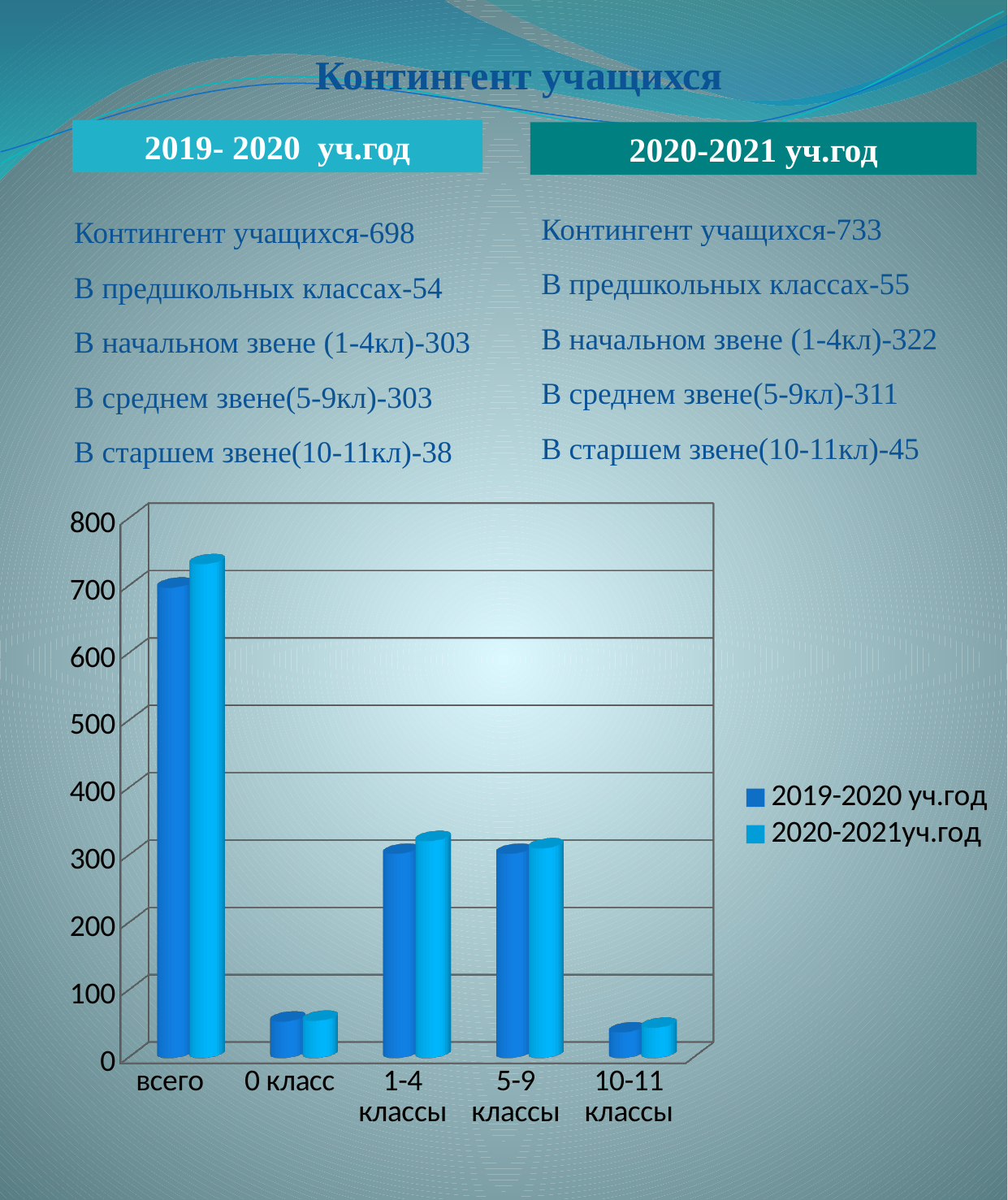
What kind of chart is shown on the slide? bar chart Which category has the lowest bars in the chart? 10-11 классы For всего, which series has the larger value: 2019-2020 уч.год or 2020-2021уч.год? 2020-2021уч.год Is the value for 1-4 классы in the 2020-2021уч.год series greater or less than 300? greater How many series does the chart legend list? 2 How many categories are shown on the x axis of the chart? 5 Is the value for 0 класс in the 2019-2020 уч.год series greater or less than 100? less Which category has the highest bars in the chart? всего Is the value for всего in the 2019-2020 уч.год series greater or less than 600? greater What is the title of the slide above the chart? Контингент учащихся In the 2019-2020 уч.год series, which is larger: 0 класс or 10-11 классы? 0 класс